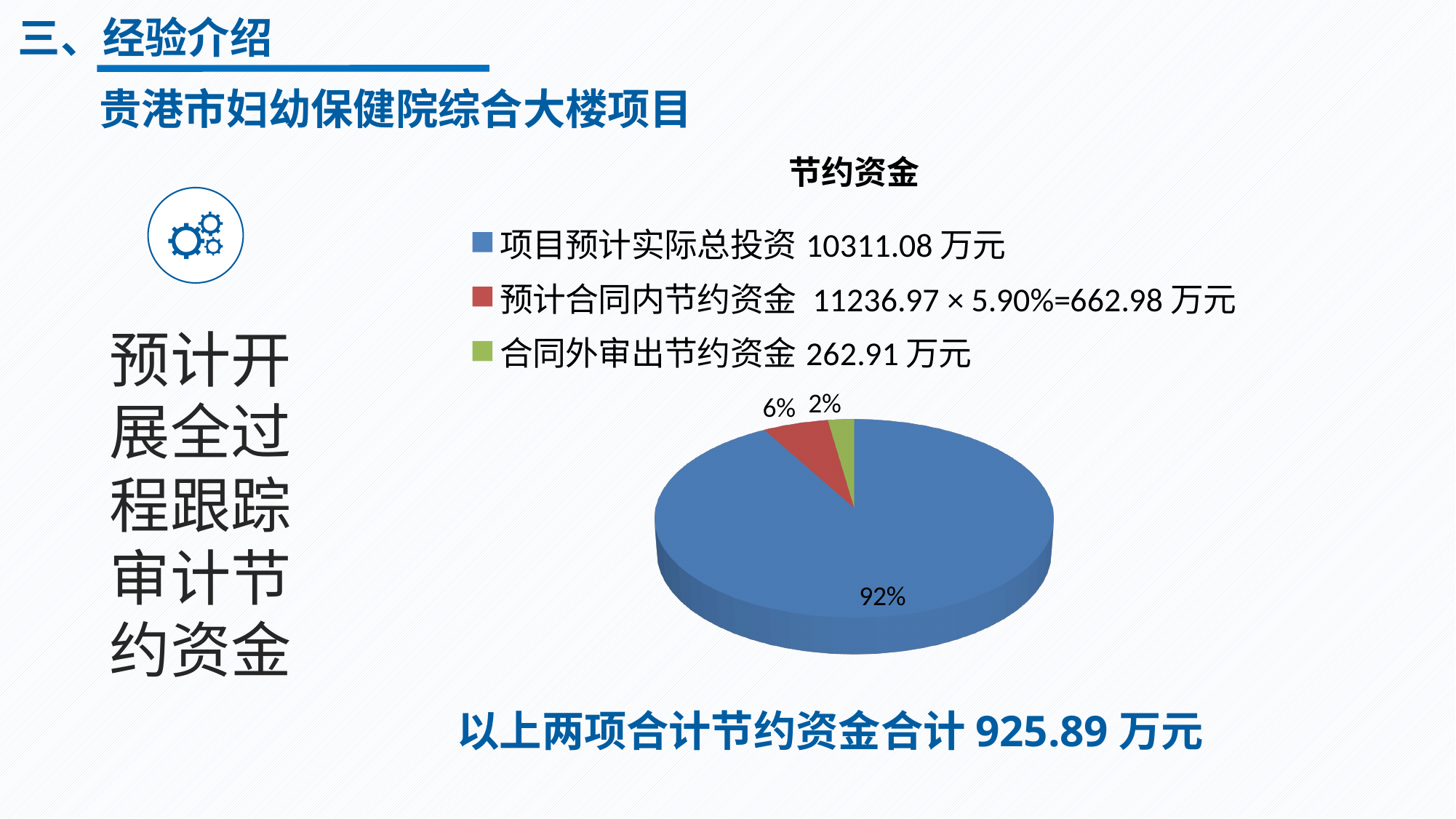
Which slice of the pie chart is the largest? 项目预计实际总投资 Which slice of the pie chart is the smallest? 合同外审出节约资金 How many slices does the pie chart have? 3 What share of the pie does 合同外审出节约资金 take? 2% What colour is the slice for 合同外审出节约资金 in the pie chart? green What share of the pie does 项目预计实际总投资 take? 92% What kind of chart is shown on the slide? pie chart What is the title of the pie chart? 节约资金 What share of the pie does 预计合同内节约资金 take? 6% How many entries does the legend of the pie chart list? 3 Which is larger in the pie chart, 预计合同内节约资金 or 合同外审出节约资金? 预计合同内节约资金 What is the difference in percentage points between the 92% slice and the 6% slice? 86%